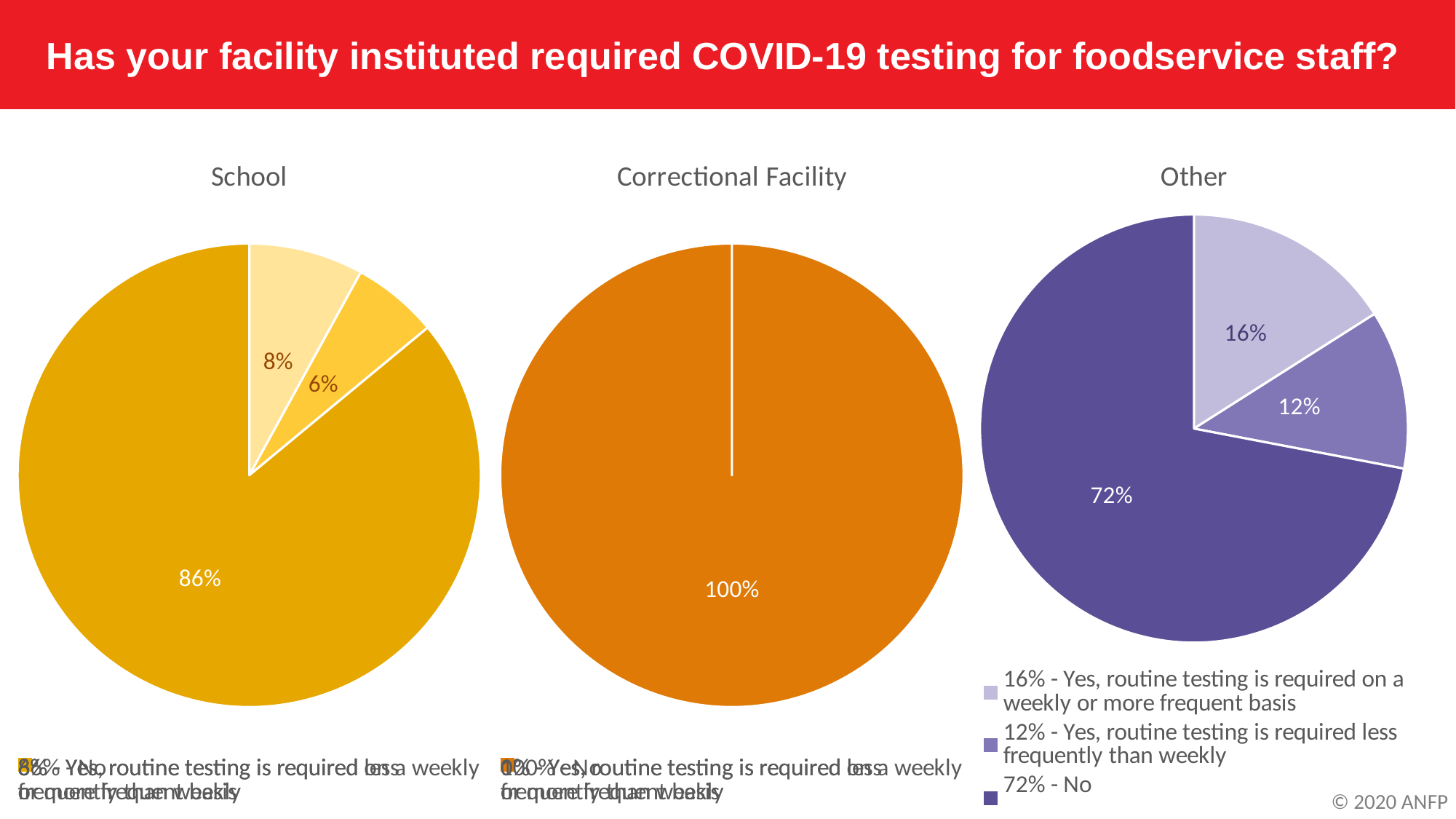
In the Other pie chart, what is the difference in percentage points between the No slice and the weekly-or-more-frequent slice? 56 In the Other pie chart, which response has the smallest share? Yes, routine testing is required less frequently than weekly In the Other pie chart, what percentage said routine testing is required on a weekly or more frequent basis? 16% How many slices does the School pie chart have? 3 In the Other pie chart, what share of respondents answered No? 72% What type of chart is used for the School, Correctional Facility and Other data? Pie chart How many entries does the legend of the Other pie chart list? 3 In the Other pie chart, what percentage said routine testing is required less frequently than weekly? 12% In the School pie chart, what is the value of the smallest slice? 6% In the Correctional Facility pie chart, what percentage does the single slice represent? 100% In the Other pie chart, which response has the largest share? No In the School pie chart, what is the value of the largest slice? 86%